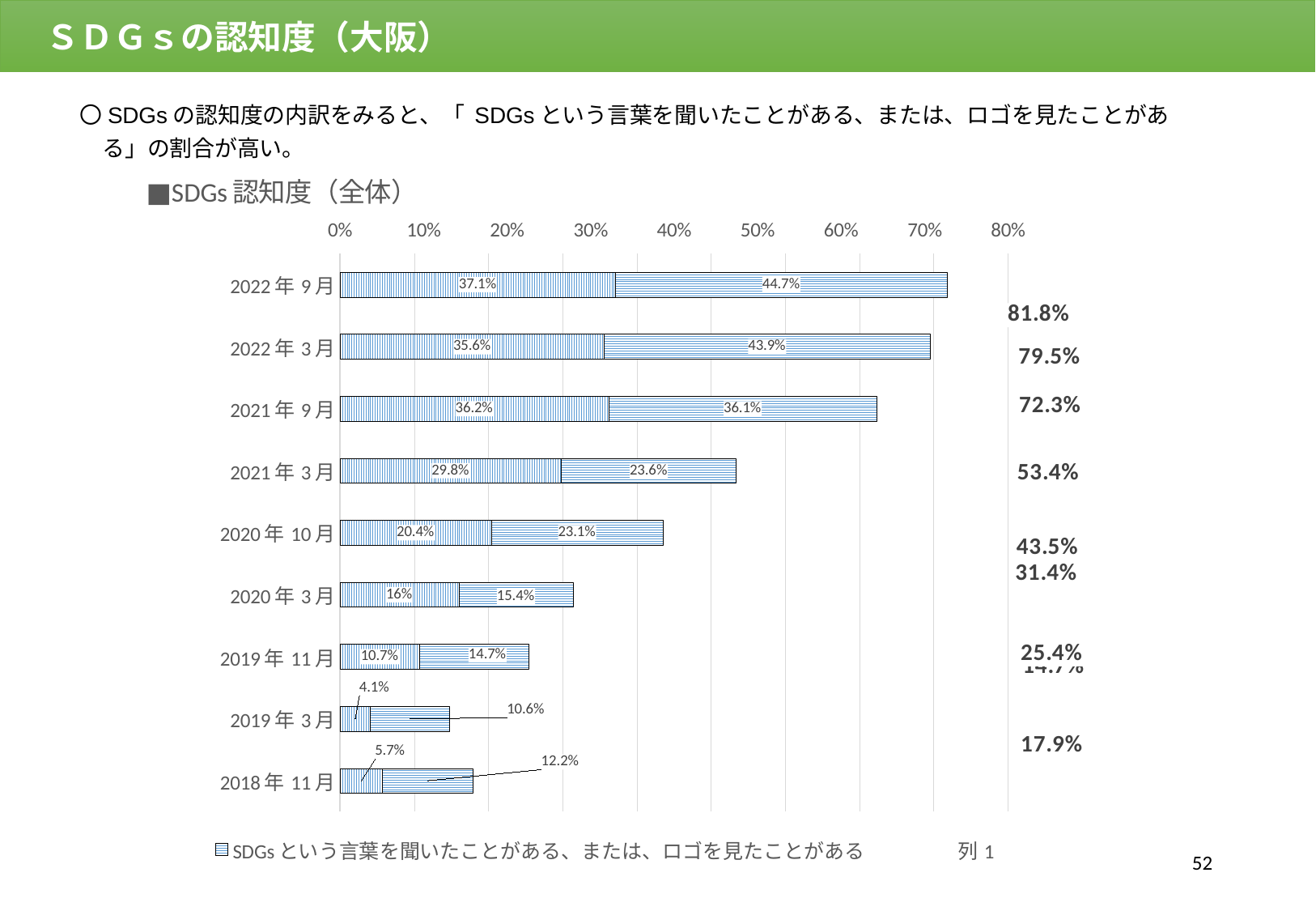
Which period has the highest value for the first series (SDGsという言葉を聞いたことがある、または、ロゴを見たことがある)? 2022年9月 Do the stacked bar totals increase or decrease from 2018年11月 to 2022年9月? increase What is the value of the first series (SDGsという言葉を聞いたことがある、または、ロゴを見たことがある) for 2022年9月? 44.7% What is the value of the second series (列1) for 2021年3月? 53.4% What kind of chart is shown on the slide? bar chart For 2019年11月, which series has the larger value: the first series (10.7%) or the second series (14.7%)? the second series (14.7%) What is the total of the stacked bar for 2022年9月? 81.8% How many series does the chart legend list? 2 Which period has the lowest value for the first series (SDGsという言葉を聞いたことがある、または、ロゴを見たことがある)? 2019年3月 For 2020年10月, what is the difference between the second series value (23.1%) and the first series value (20.4%)? 2.7% Is the total length of the stacked bar for 2018年11月 greater or less than 20%? less How many time periods (categories) are plotted in the chart? 9